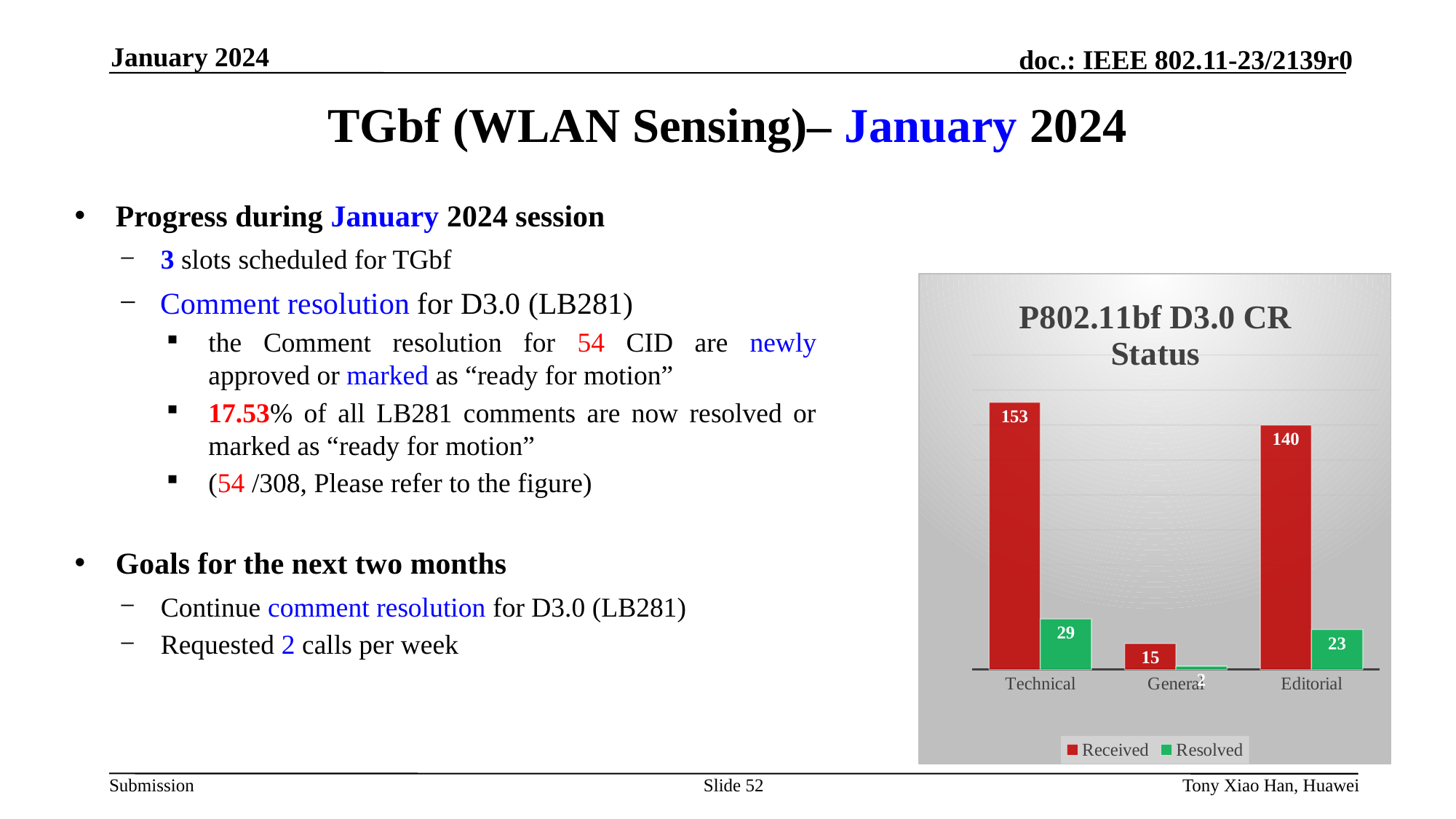
What is the Received value for Technical in the P802.11bf D3.0 CR Status chart? 153 What is the Received value for General in the P802.11bf D3.0 CR Status chart? 15 In the P802.11bf D3.0 CR Status chart, how much larger is the Received value for Technical than for Editorial? 13 Which category has the lowest Received value in the P802.11bf D3.0 CR Status chart? General How many categories are shown on the x axis of the P802.11bf D3.0 CR Status chart? 3 What is the Resolved value for Technical in the P802.11bf D3.0 CR Status chart? 29 How many series does the legend of the P802.11bf D3.0 CR Status chart list? 2 What is the Received value for Editorial in the P802.11bf D3.0 CR Status chart? 140 What kind of chart is the P802.11bf D3.0 CR Status chart? bar chart Which category has the highest Received value in the P802.11bf D3.0 CR Status chart? Technical What is the Resolved value for Editorial in the P802.11bf D3.0 CR Status chart? 23 In the P802.11bf D3.0 CR Status chart, is the Resolved value larger for Technical or for Editorial? Technical